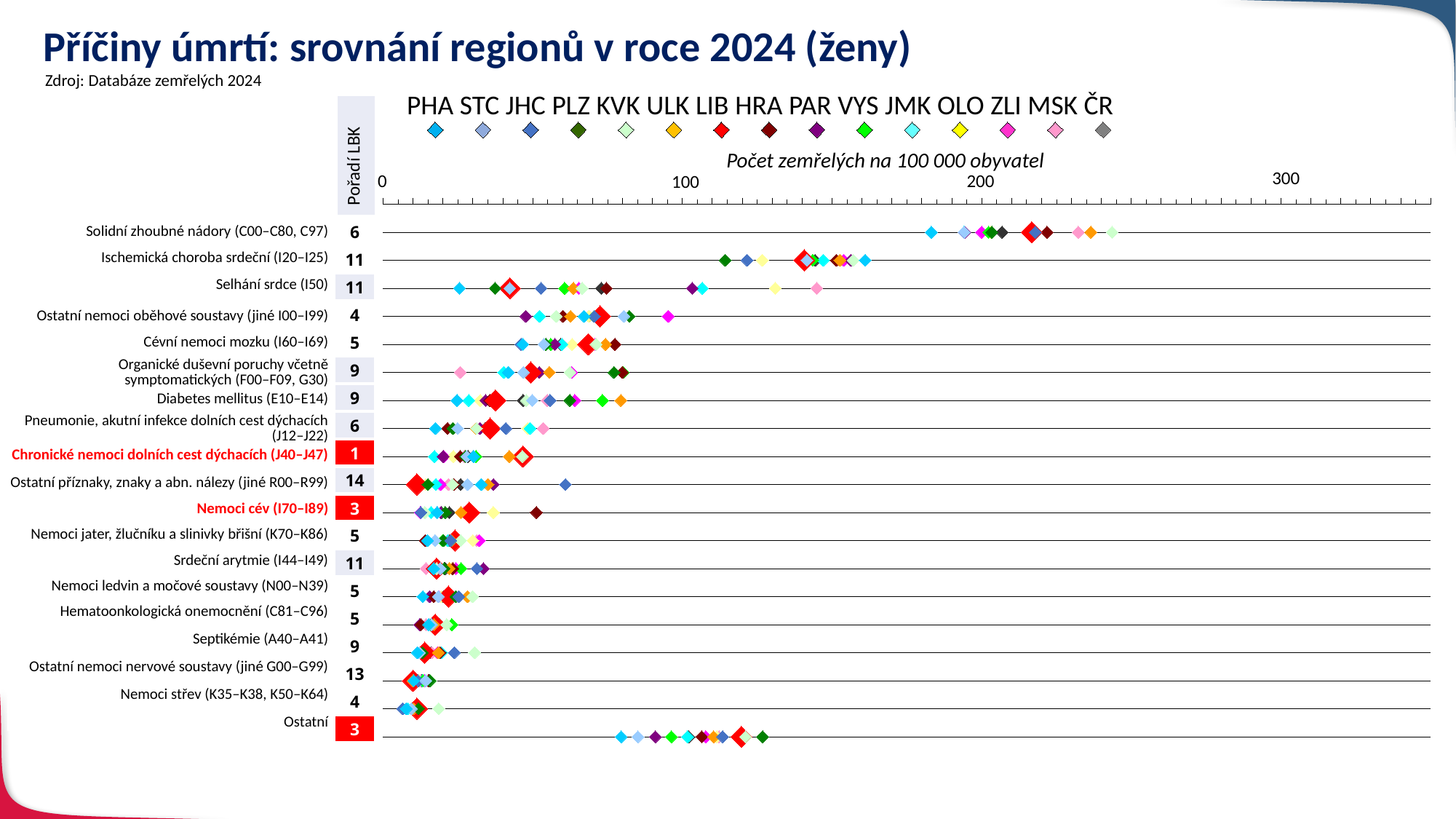
Are the values for Ischemická choroba srdeční (I20–I25) greater or less than 200 deaths per 100 000 inhabitants? less What is the LBK rank (Pořadí LBK) shown for Ostatní příznaky, znaky a abn. nálezy (jiné R00–R99)? 14 What kind of chart is shown on the slide? Dot plot (scatter chart) Which cause of death has the highest values across all regions on the chart? Solidní zhoubné nádory (C00–C80, C97) Are the values for Solidní zhoubné nádory (C00–C80, C97) greater or less than 100 deaths per 100 000 inhabitants? greater What is the LBK rank (Pořadí LBK) shown for Solidní zhoubné nádory (C00–C80, C97)? 6 What is the LBK rank (Pořadí LBK) shown for Chronické nemoci dolních cest dýchacích (J40–J47)? 1 How many regions/series does the legend list? 15 What is the LBK rank (Pořadí LBK) shown for Nemoci cév (I70–I89)? 3 How many causes of death (categories) are plotted on the chart? 19 Which has higher values on the chart: Ostatní or Nemoci střev (K35–K38, K50–K64)? Ostatní What is the title of the chart on the slide? Příčiny úmrtí: srovnání regionů v roce 2024 (ženy)